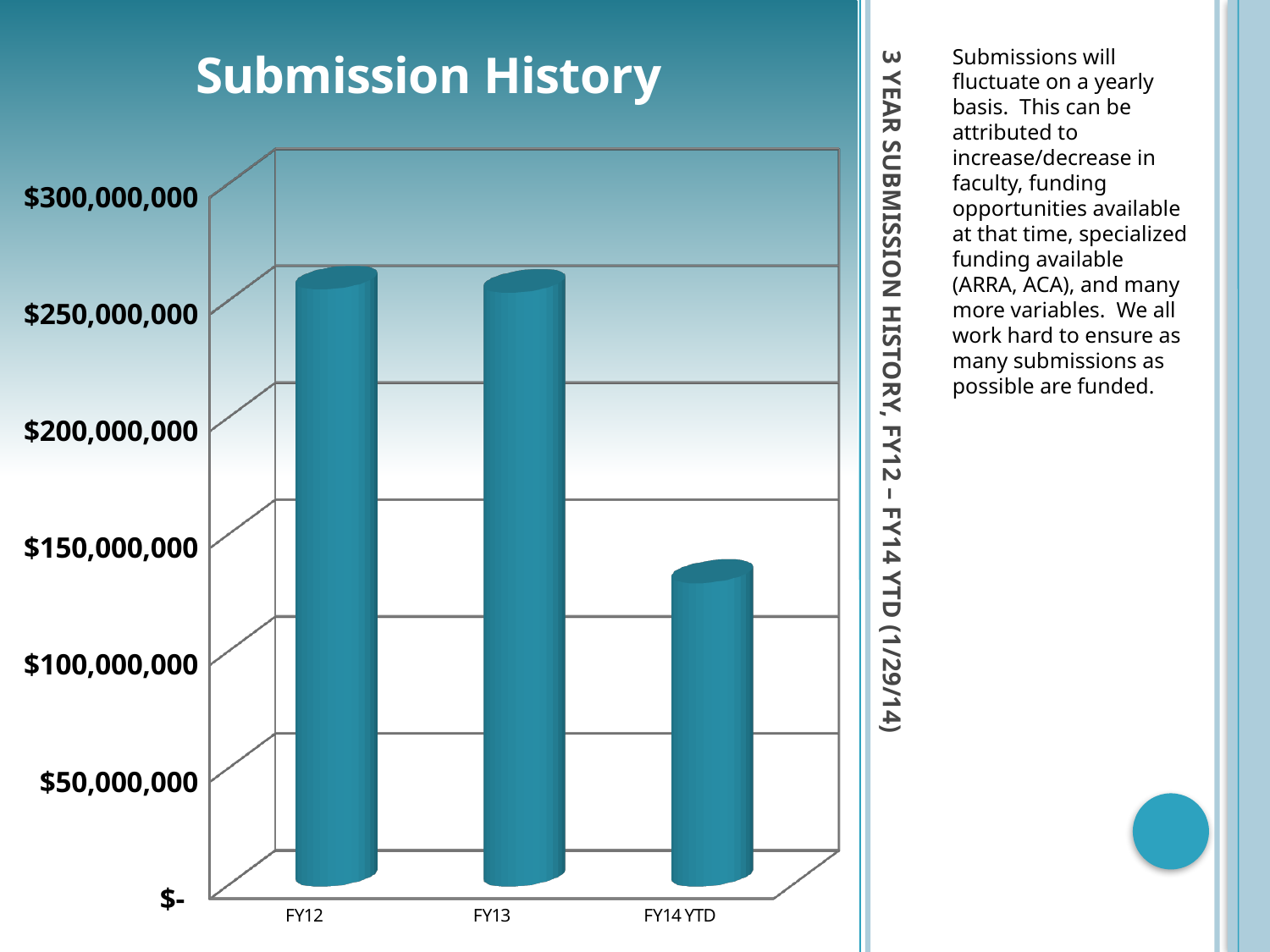
What is the title of the chart? Submission History What kind of chart is shown on the slide? bar chart Is the value for FY12 greater or less than $200,000,000? greater Which is larger, the value for FY13 or the value for FY14 YTD? FY13 Is the value for FY14 YTD greater or less than $100,000,000? greater Is the value for FY14 YTD greater or less than $150,000,000? less Which is larger, the value for FY12 or the value for FY14 YTD? FY12 How many categories are plotted on the x axis of the chart? 3 What is the label of the highest tick on the y axis? $300,000,000 Which category has the lowest value in the chart? FY14 YTD